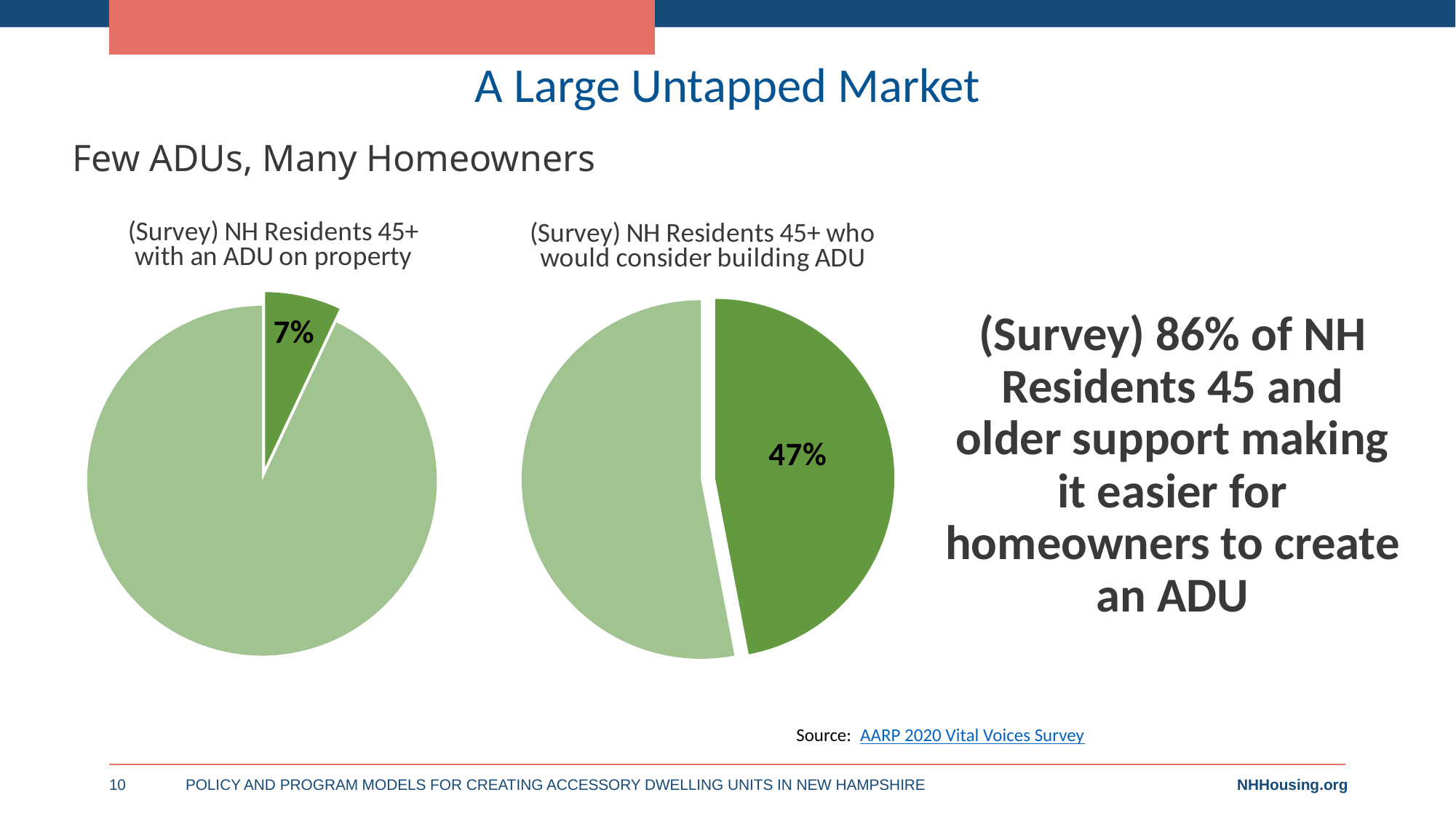
How many slices does the right pie chart have? 2 In the right pie chart, what percentage of NH residents 45+ would consider building an ADU? 47% In the left pie chart, what percentage of NH residents 45+ have an ADU on their property? 7% What is the difference in percentage points between the share of residents who would consider building an ADU (right chart) and the share who already have an ADU (left chart)? 40 percentage points In the left pie chart, is the dark green slice more or less than a quarter of the pie? Less What kind of chart is used for '(Survey) NH Residents 45+ with an ADU on property'? Pie chart What is the title of the left pie chart? (Survey) NH Residents 45+ with an ADU on property What kind of chart is used for '(Survey) NH Residents 45+ who would consider building ADU'? Pie chart How many slices does the left pie chart have? 2 In the right pie chart, is the dark green slice more or less than half of the pie? Less Which is larger: the labeled slice in the left pie chart (residents with an ADU) or the labeled slice in the right pie chart (residents who would consider building an ADU)? The right pie chart's slice (47%) What source is cited for the pie chart data on the slide? AARP 2020 Vital Voices Survey